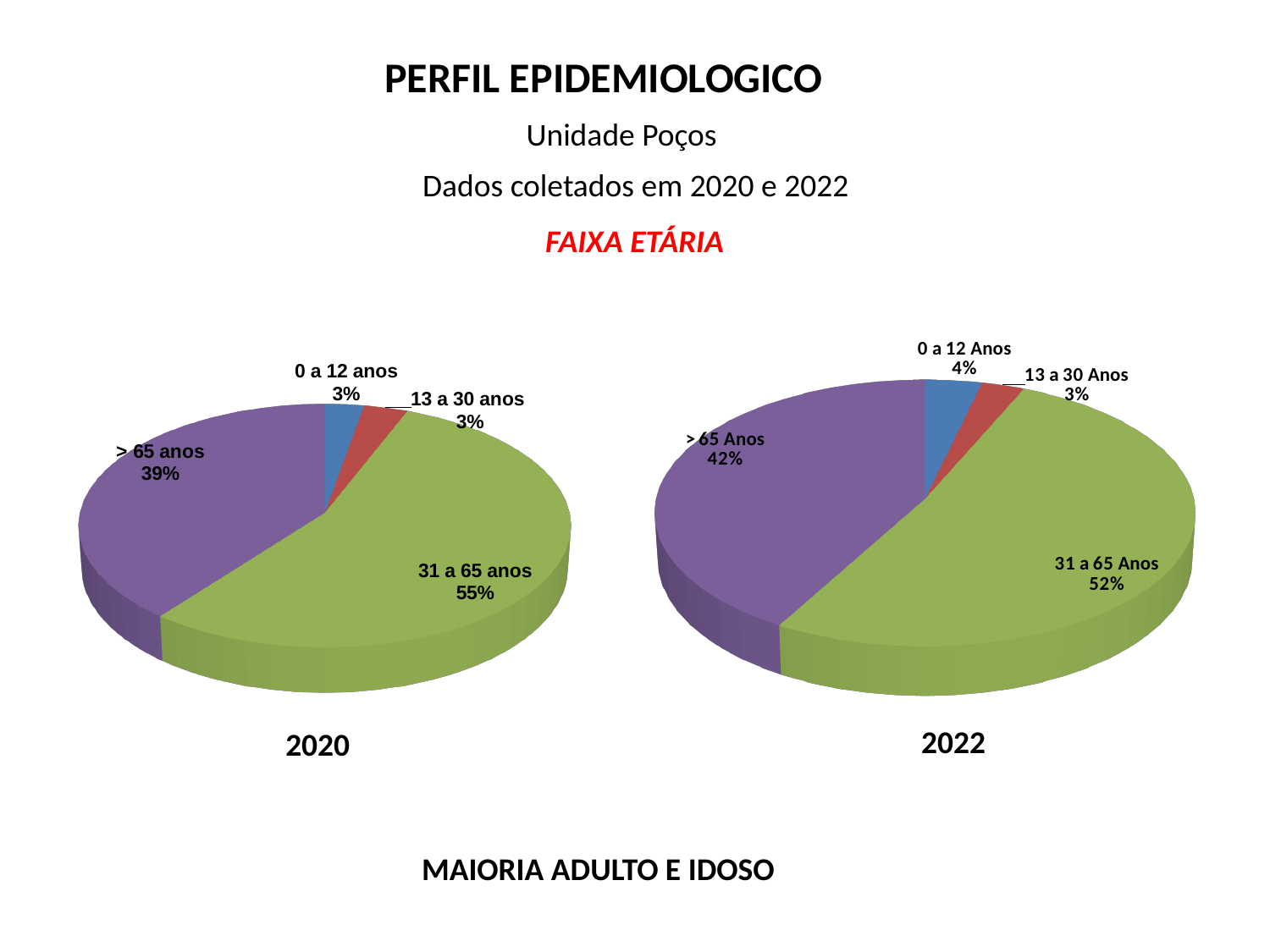
In the 2022 pie chart, which age group has the smallest slice? 13 a 30 Anos In the 2022 pie chart, what share is shown for 0 a 12 Anos? 4% Which is larger: the share for > 65 anos in the 2020 chart or the share for > 65 Anos in the 2022 chart? 2022 What colour is the 31 a 65 anos slice in the 2020 pie chart? Green What type of chart is used for the 2022 data? Pie chart In the 2020 pie chart, what share is shown for 31 a 65 anos? 55% In the 2022 pie chart, what share is shown for > 65 Anos? 42% In the 2020 pie chart, what is the difference between the shares for 31 a 65 anos and > 65 anos? 16% In the 2020 pie chart, which age group has the largest slice? 31 a 65 anos How many slices does the 2020 pie chart have? 4 In the 2022 pie chart, what is the difference between the shares for 31 a 65 Anos and > 65 Anos? 10%